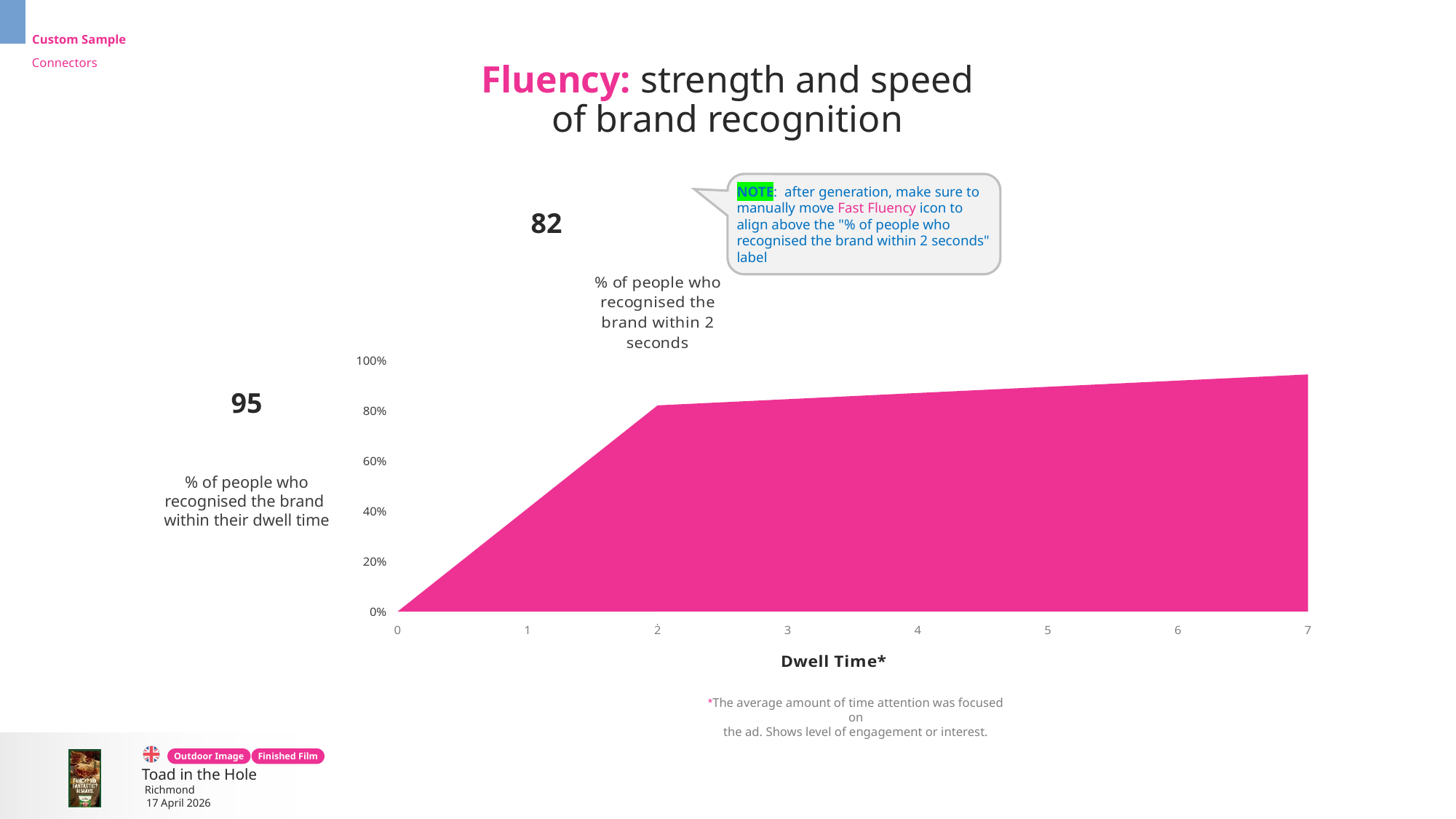
What percentage of people recognised the brand within their dwell time, according to the figure printed on the slide? 95 What is the value of the chart at dwell time 0? 0% How many tick labels are shown on the x axis of the chart? 8 What kind of chart is shown on the slide? area chart What is the title of the x axis of the chart? Dwell Time* What percentage of people recognised the brand within 2 seconds, according to the figure printed on the slide? 82 Is the value at dwell time 1 greater or less than 60%? less Is the value at dwell time 7 greater or less than 80%? greater What is the highest tick label on the y axis of the chart? 100% Is the value at dwell time 2 greater or less than 60%? greater How much higher is the percentage who recognised the brand within their dwell time than the percentage who recognised it within 2 seconds? 13 Do the values rise or fall as dwell time increases from 0 to 7? rise